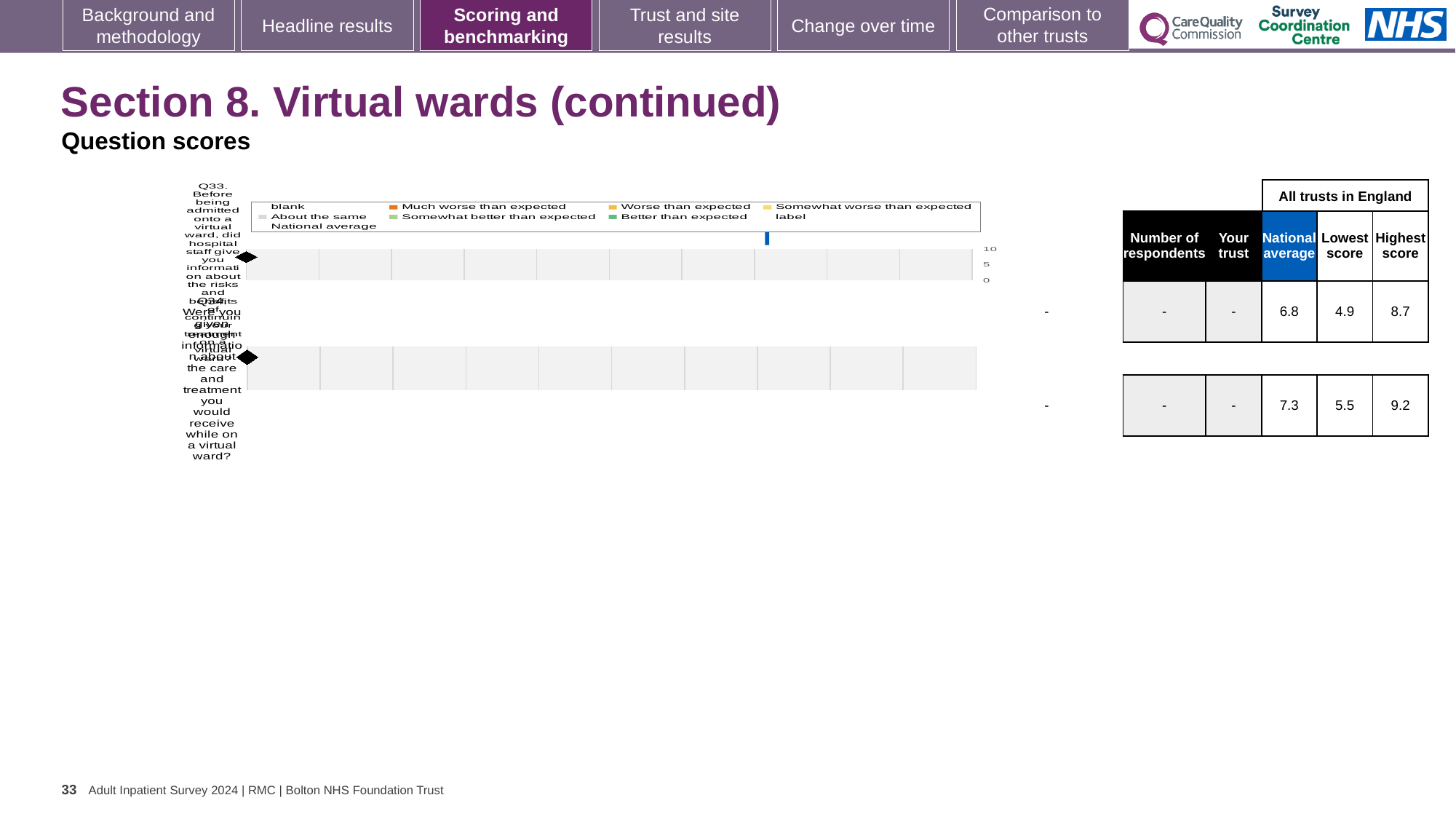
In the table beside the chart, what is the difference between the highest and lowest score for Q34? 3.7 In the table beside the chart, what is the lowest score for Q34? 5.5 What kind of chart is shown on the slide? bar chart In the table beside the chart, what is the national average score for Q33? 6.8 In the table beside the chart, what is the highest score for Q33? 8.7 In the table beside the chart, which question has the higher national average, Q33 or Q34? Q34 What is the highest value shown on the chart's axis? 10 Which legend entry is shown in green as 'Better than expected' or 'Much worse than expected'? Better than expected How many questions (categories) are plotted on the chart? 2 In the table beside the chart, what is the national average score for Q34? 7.3